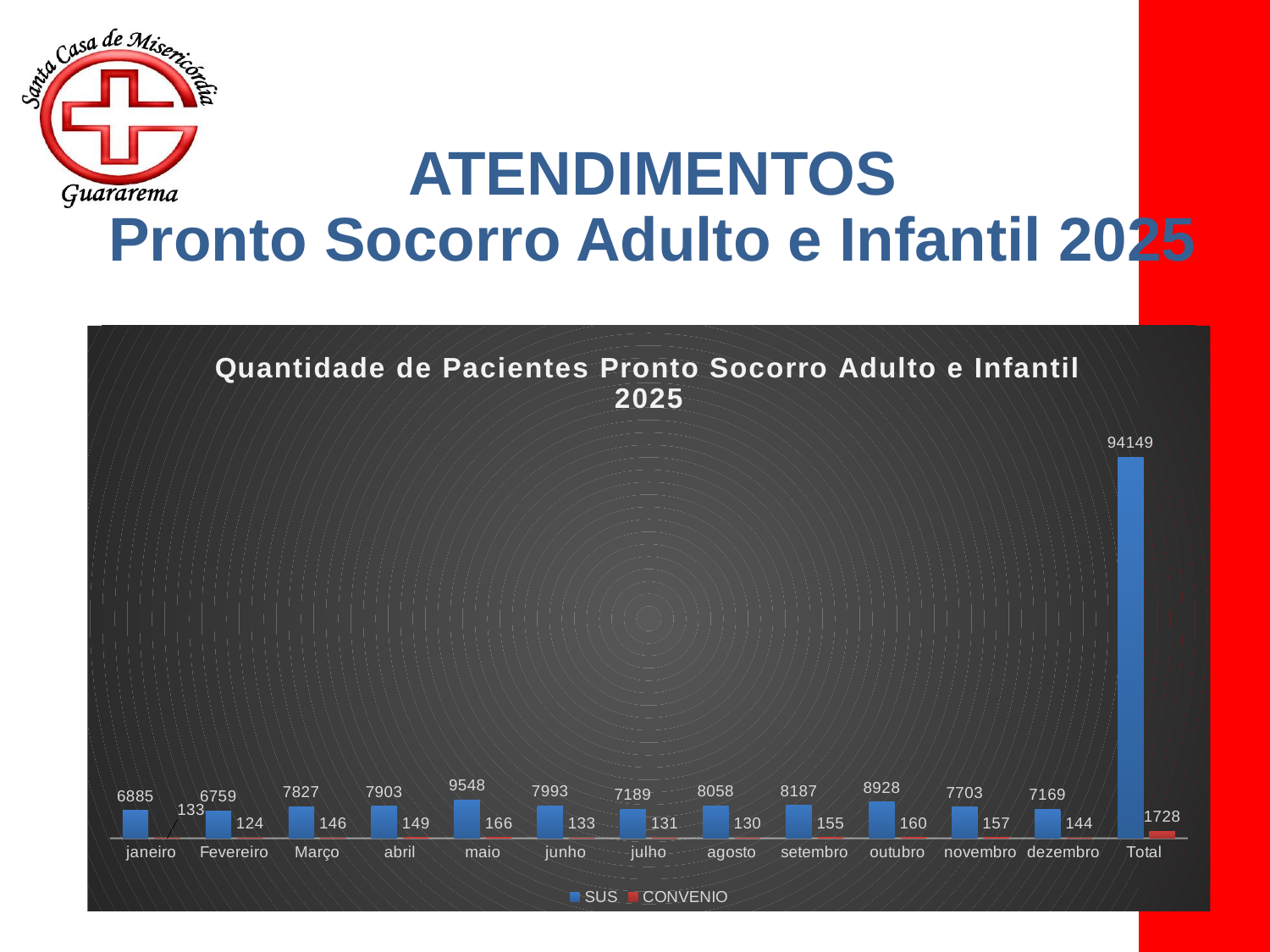
What is the SUS value shown for the Total category? 94149 What is the difference between the SUS values for maio and Fevereiro? 2789 Which month has the lowest CONVENIO value? Fevereiro What is the CONVENIO value for outubro? 160 How many series does the legend list? 2 What kind of chart is shown on the slide? bar chart What is the title of the chart? Quantidade de Pacientes Pronto Socorro Adulto e Infantil 2025 What is the SUS value for maio? 9548 Excluding the Total category, which month has the highest SUS value? maio Which is larger, the SUS value for agosto or the SUS value for julho? agosto How many categories are shown on the x axis? 13 Which series is shown in red in the legend? CONVENIO